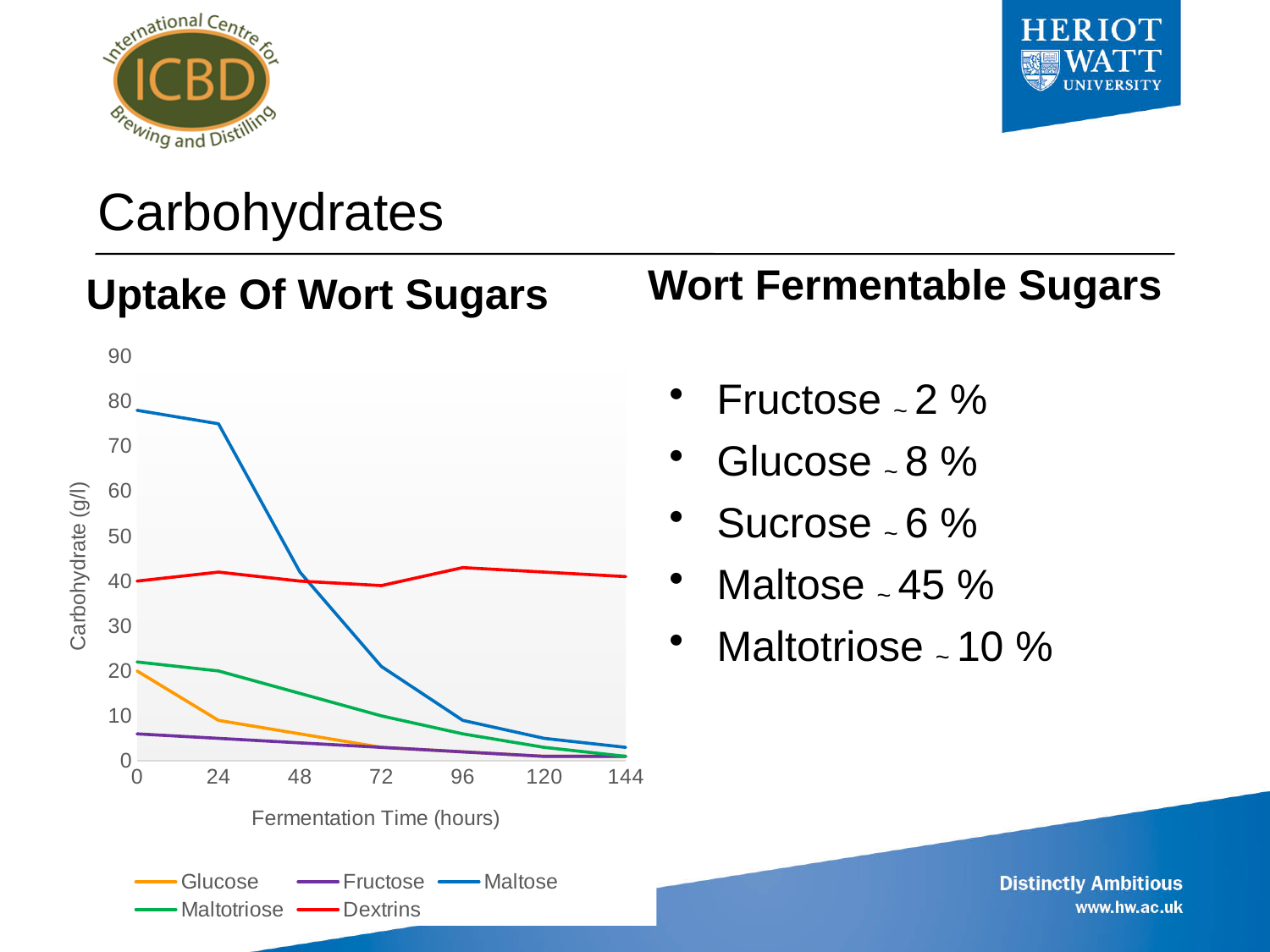
What type of chart is shown under the title 'Uptake Of Wort Sugars'? Line chart Which series has the lowest carbohydrate value at 0 hours? Fructose Which series has the highest value at 144 hours? Dextrins How many series does the legend of the 'Uptake Of Wort Sugars' chart list? 5 Is the value for Dextrins at 96 hours greater or less than 30? greater Which series has the highest carbohydrate value at 0 hours? Maltose Is the value for Maltose at 0 hours greater or less than 70? greater How many fermentation time points are marked on the x axis of the chart? 7 Does the Maltose line rise or fall as fermentation time increases? Fall What is the label on the x axis of the chart? Fermentation Time (hours) Is the value for Glucose at 24 hours greater or less than 20? less At 72 hours, which is larger: Dextrins or Maltose? Dextrins